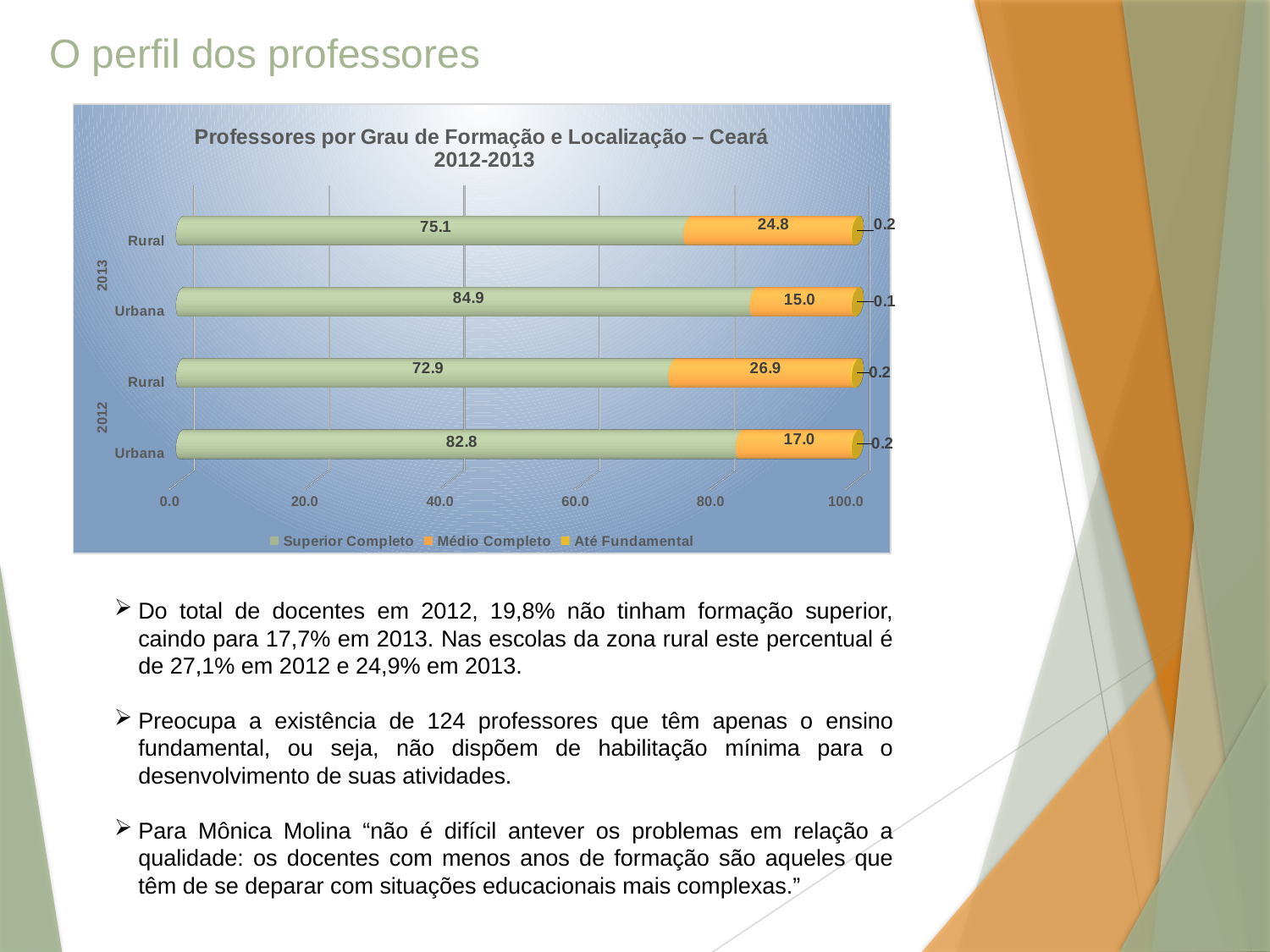
What is the Superior Completo value for Rural in 2013? 75.1 What kind of chart is shown on the slide? Stacked bar chart Which is larger, the Superior Completo value for Urbana 2012 or for Urbana 2013? Urbana 2013 What is the Até Fundamental value for Urbana in 2013? 0.1 What is the title of the chart? Professores por Grau de Formação e Localização – Ceará 2012-2013 How many series does the legend list? 3 Which category has the lowest Superior Completo value? Rural 2012 How many bars are plotted in the chart? 4 What is the Médio Completo value for Urbana in 2012? 17.0 What is the difference between the Médio Completo values for Rural 2012 and Rural 2013? 2.1 Which category has the highest Superior Completo value? Urbana 2013 What is the total of the stacked bar for Rural 2013? 100.1